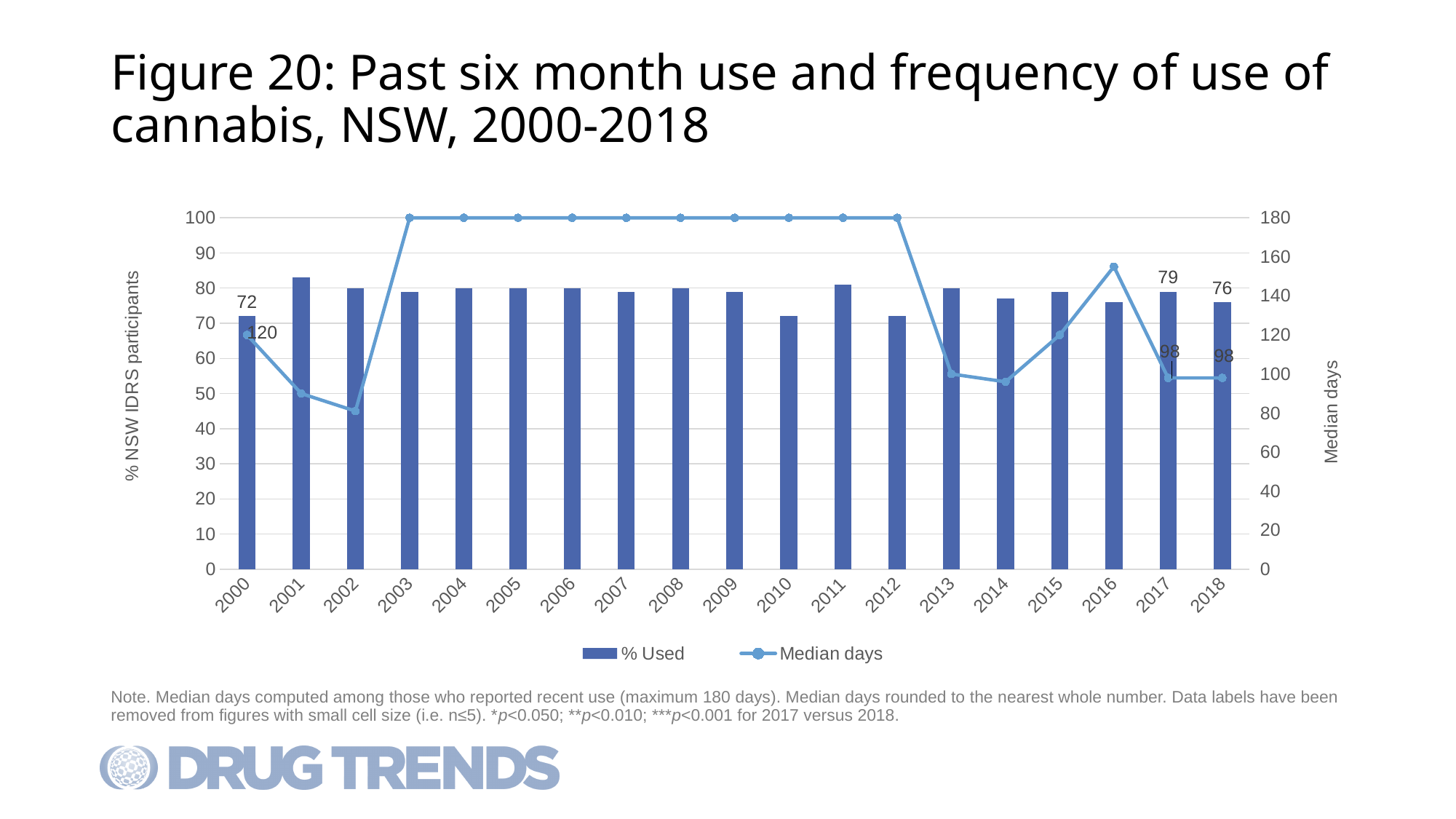
How many series does the legend list? 2 What is the % Used value for 2017? 79 By how much did % Used fall from 2017 to 2018? 3 What is the difference between the Median days value in 2000 and in 2018? 22 What is the Median days value for 2000? 120 Does the Median days line rise or fall from 2012 to 2014? fall What is the % Used value for 2000? 72 Which year has the higher % Used value, 2017 or 2018? 2017 Is the Median days value for 2003 greater or less than 160? greater What is the Median days value for 2018? 98 How many years are shown on the x axis? 19 What kind of chart is this? Combined bar and line chart